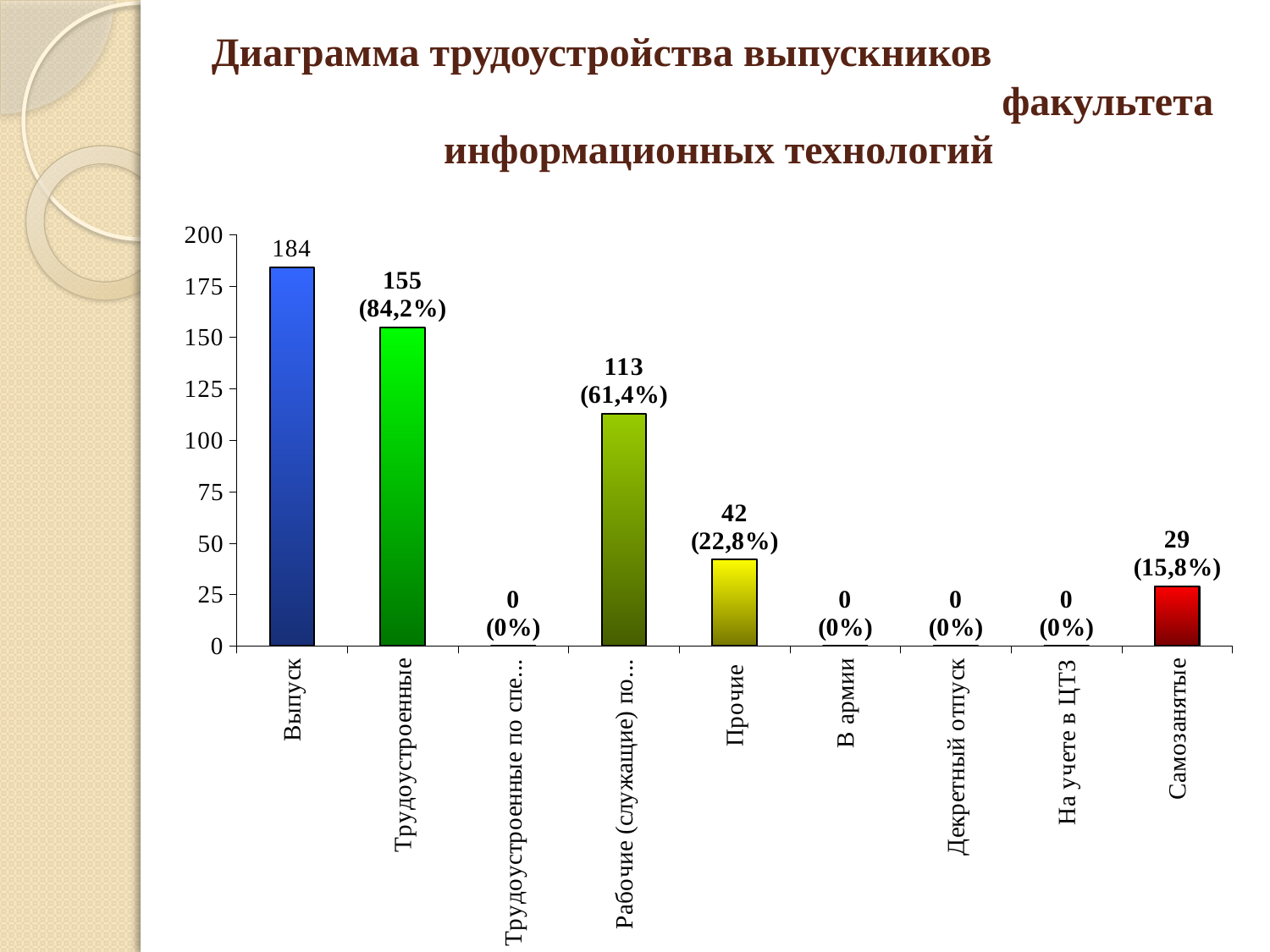
What percentage is shown for Трудоустроенные? 84,2% What kind of chart is shown on the slide? Bar chart Which is larger, the value for Прочие or the value for Самозанятые? Прочие What is the difference between the values for Выпуск and Трудоустроенные? 29 What is the value for В армии? 0 Which category has the highest value? Выпуск What percentage is shown for Самозанятые? 15,8% What is the value for Трудоустроенные? 155 Is the value for Самозанятые greater or less than 50? less What is the value for Выпуск? 184 How many categories are shown on the x axis? 9 What is the value for Прочие? 42